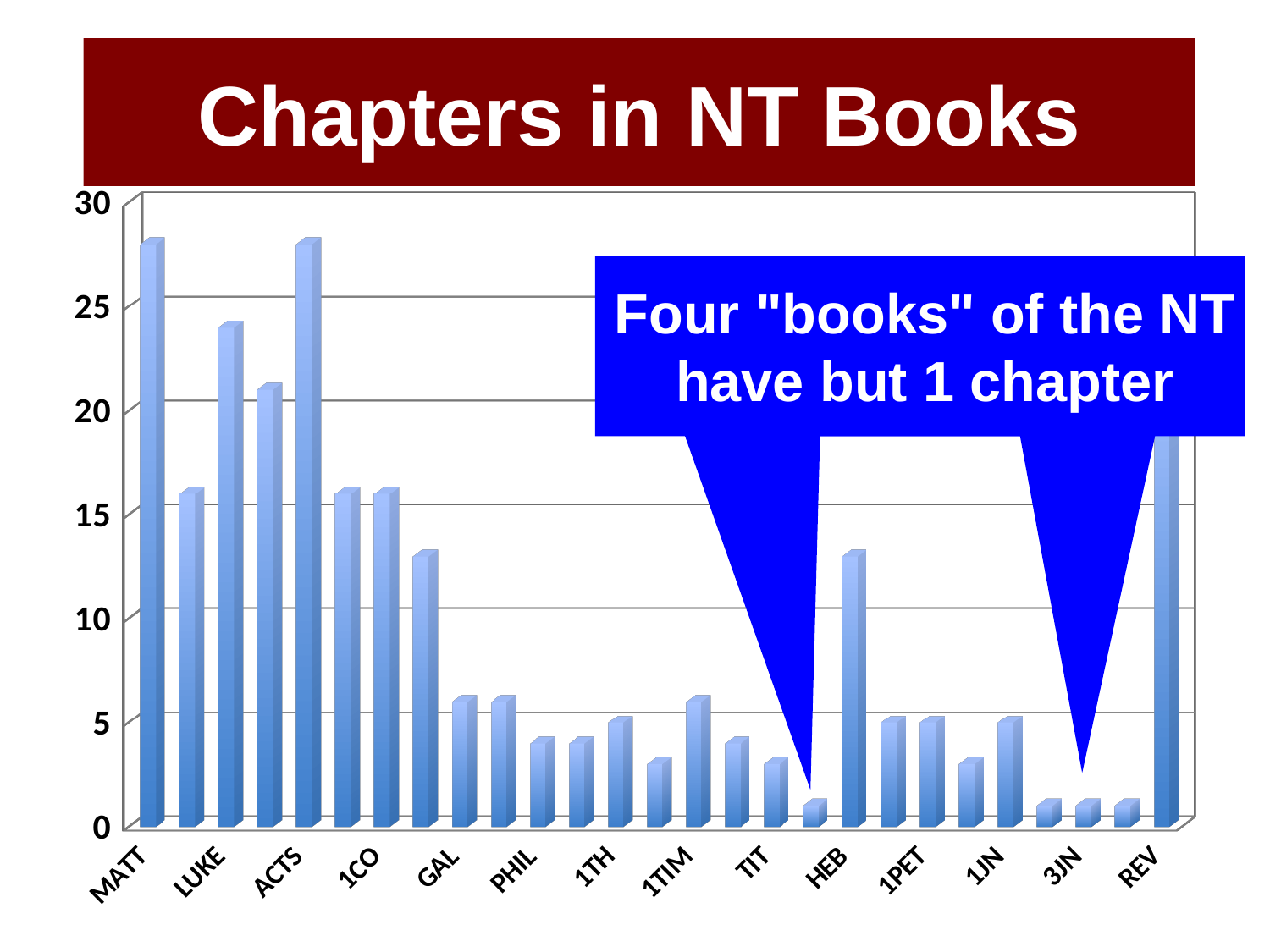
Is the value for MATT greater or less than 25? greater Is the value for HEB greater or less than 10? greater Is the value for 3JN greater or less than 5? less Which has more chapters, HEB or GAL? HEB Which has more chapters, REV or HEB? REV What is the title of the chart? Chapters in NT Books What kind of chart is shown on the slide? bar chart According to the callout on the chart, how many NT "books" have only 1 chapter? Four Which has more chapters, MATT or LUKE? MATT